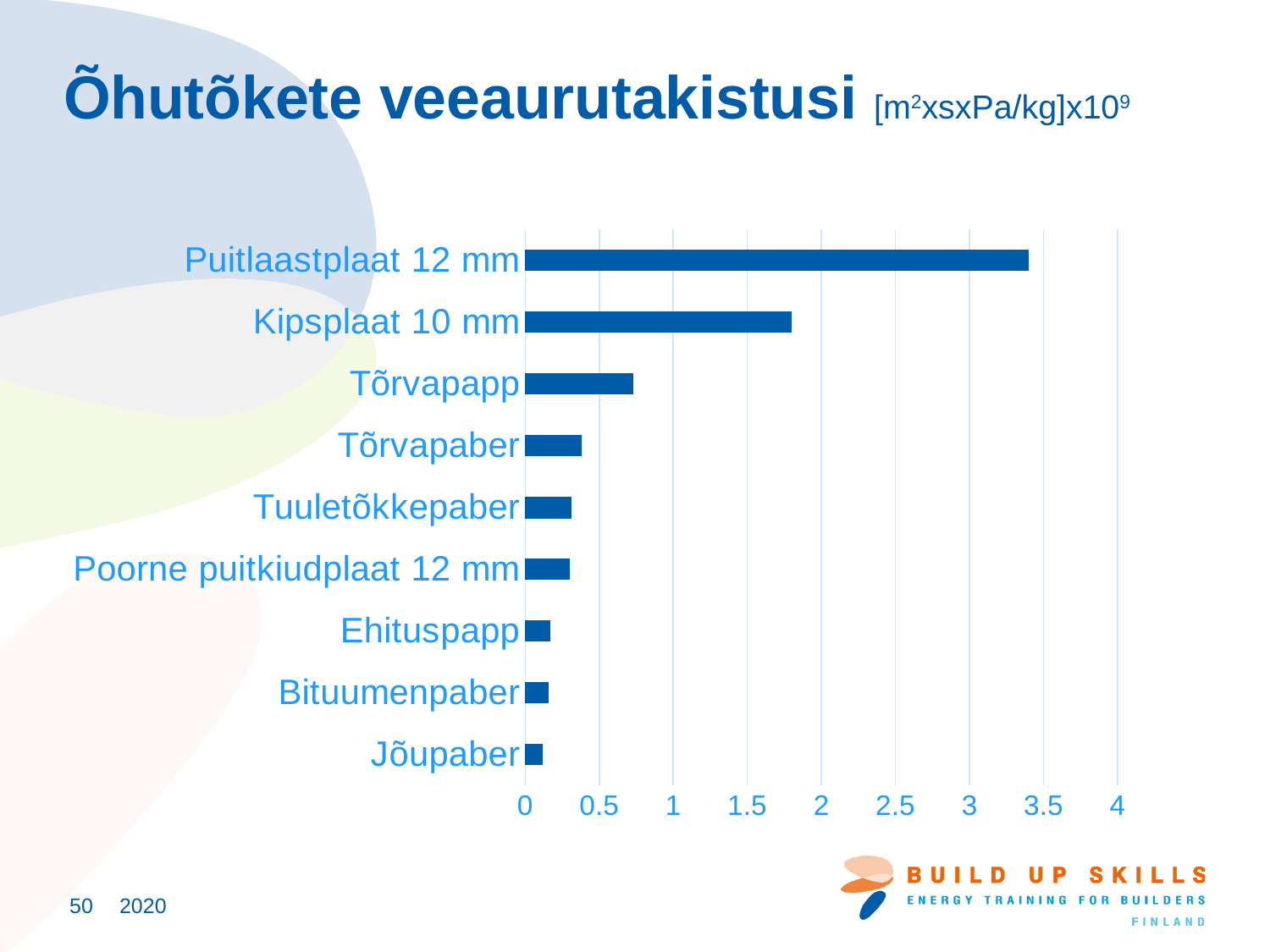
Is the value for Puitlaastplaat 12 mm greater or less than 3? greater Is the value for Kipsplaat 10 mm greater or less than 2? less Is the value for Kipsplaat 10 mm greater or less than 1.5? greater Which material has the highest value in the chart? Puitlaastplaat 12 mm Which has the larger value, Kipsplaat 10 mm or Tõrvapapp? Kipsplaat 10 mm What kind of chart is shown on the slide? bar chart Which has the larger value, Puitlaastplaat 12 mm or Kipsplaat 10 mm? Puitlaastplaat 12 mm Which has the larger value, Tõrvapapp or Tõrvapaber? Tõrvapapp What is the title of the chart on the slide? Õhutõkete veeaurutakistusi How many materials (categories) are plotted in the chart? 9